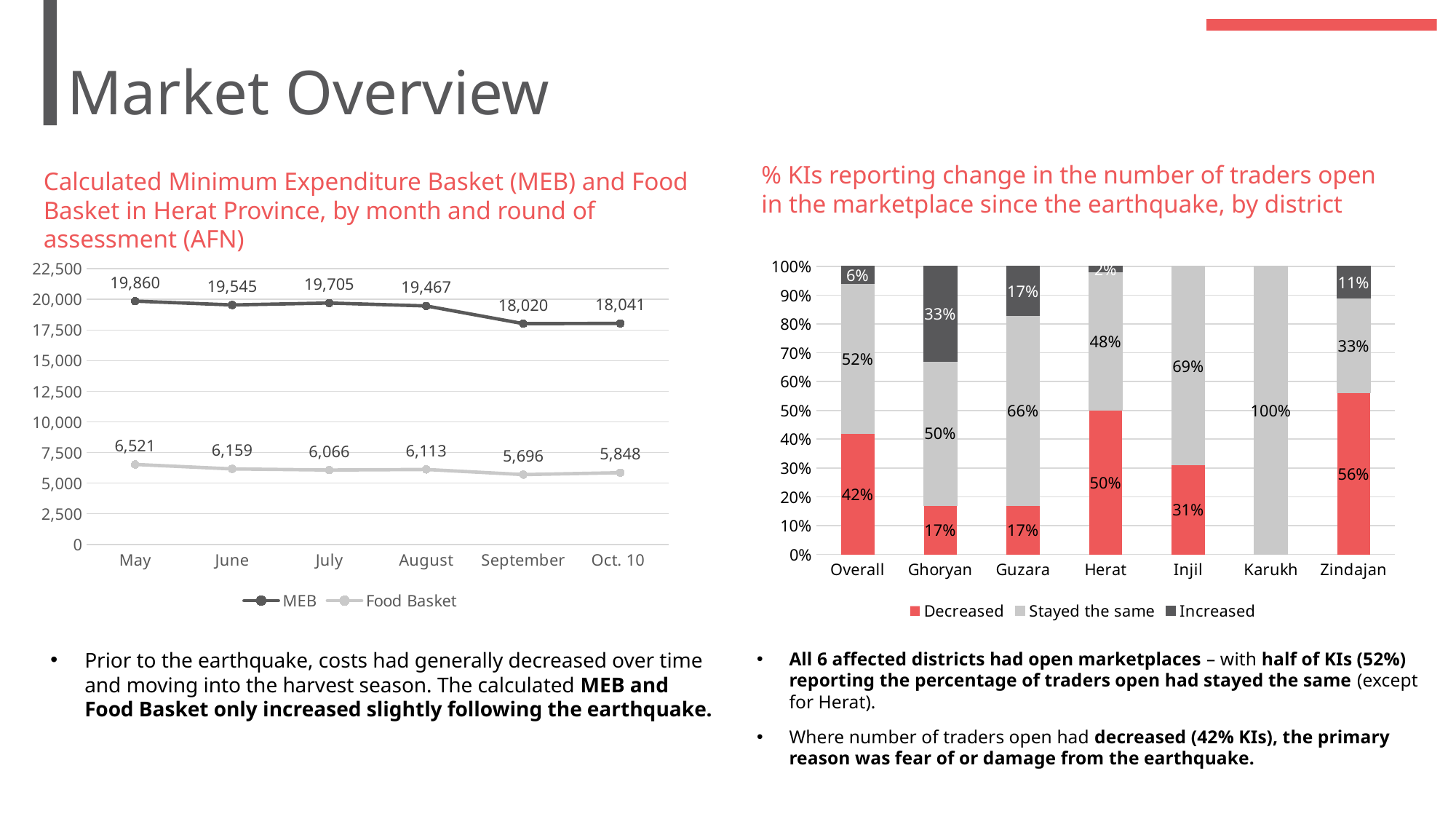
In the left chart (MEB and Food Basket), what is the Food Basket value for May? 6,521 In the right chart (% KIs reporting change in the number of traders open), is the 'Decreased' share larger for Overall or for Herat? Herat In the left chart (MEB and Food Basket), which month has the highest MEB value? May In the left chart (MEB and Food Basket), what is the MEB value for September? 18,020 In the right chart (% KIs reporting change in the number of traders open), what percentage of KIs in Zindajan reported the number of traders had decreased? 56% What kind of chart is the left chart, 'Calculated Minimum Expenditure Basket (MEB) and Food Basket in Herat Province'? Line chart In the right chart (% KIs reporting change in the number of traders open), which district has the highest 'Decreased' share? Zindajan In the left chart (MEB and Food Basket), which month has the lowest Food Basket value? September In the left chart (MEB and Food Basket), how many series does the legend list? 2 In the left chart (MEB and Food Basket), what is the difference between the MEB value in May and the MEB value on Oct. 10? 1,819 In the left chart (MEB and Food Basket), how many time points are plotted along the x axis? 6 What kind of chart is the right chart, '% KIs reporting change in the number of traders open in the marketplace since the earthquake, by district'? Stacked bar chart